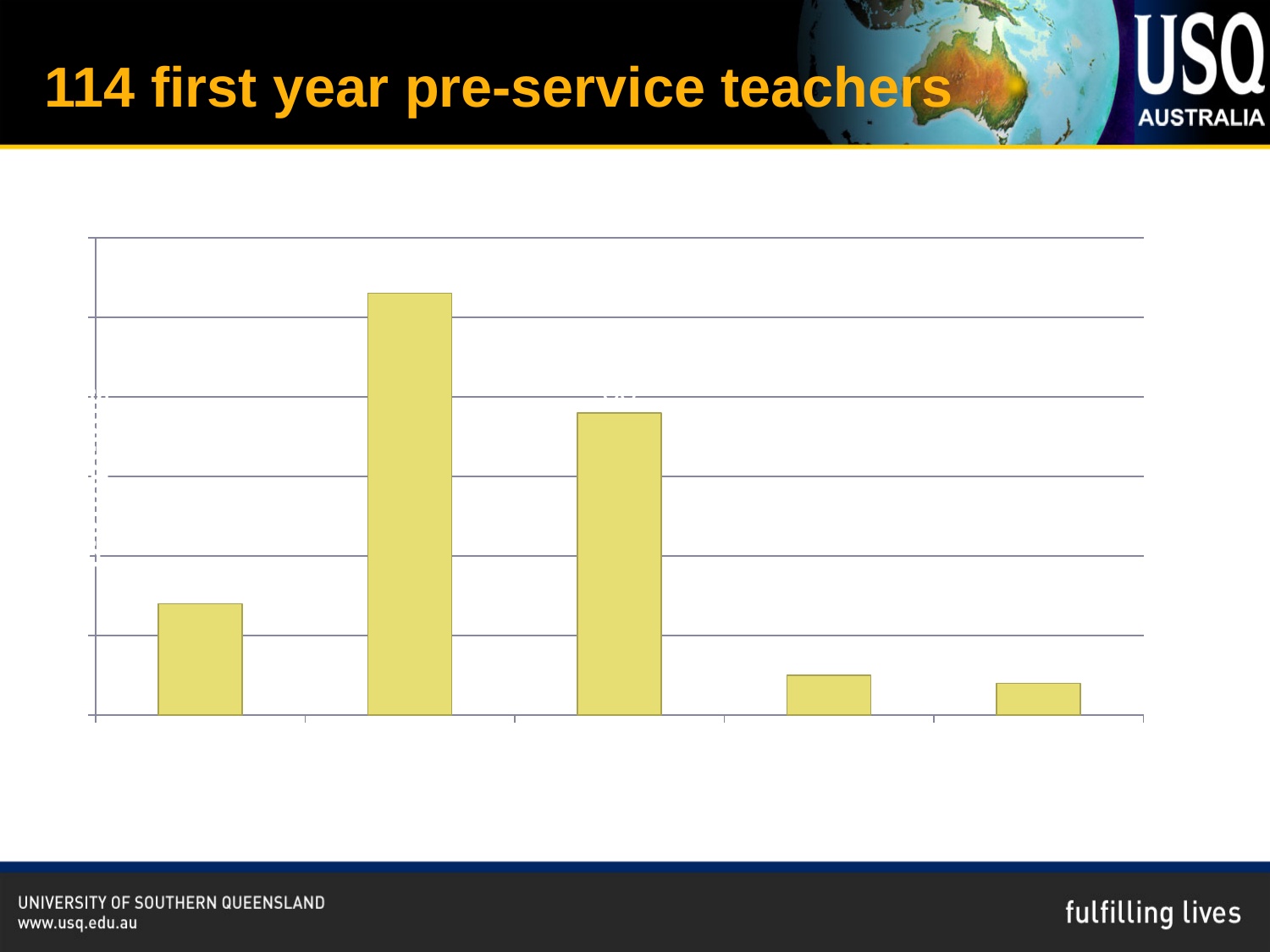
What is the title of the slide containing the chart? 114 first year pre-service teachers How many bars are plotted in the chart? 5 Do the bar heights rise or fall from the third bar to the fifth bar? fall Is the second bar from the left taller or shorter than the third bar from the left? taller Is the fourth bar from the left taller or shorter than the fifth bar from the left? taller What kind of chart is shown on the slide? bar chart What colour are the bars in the chart? yellow Counting from the left, which bar in the chart is the tallest? the second bar Counting from the left, which bar in the chart is the shortest? the fifth bar Is the first bar from the left taller or shorter than the fourth bar from the left? taller